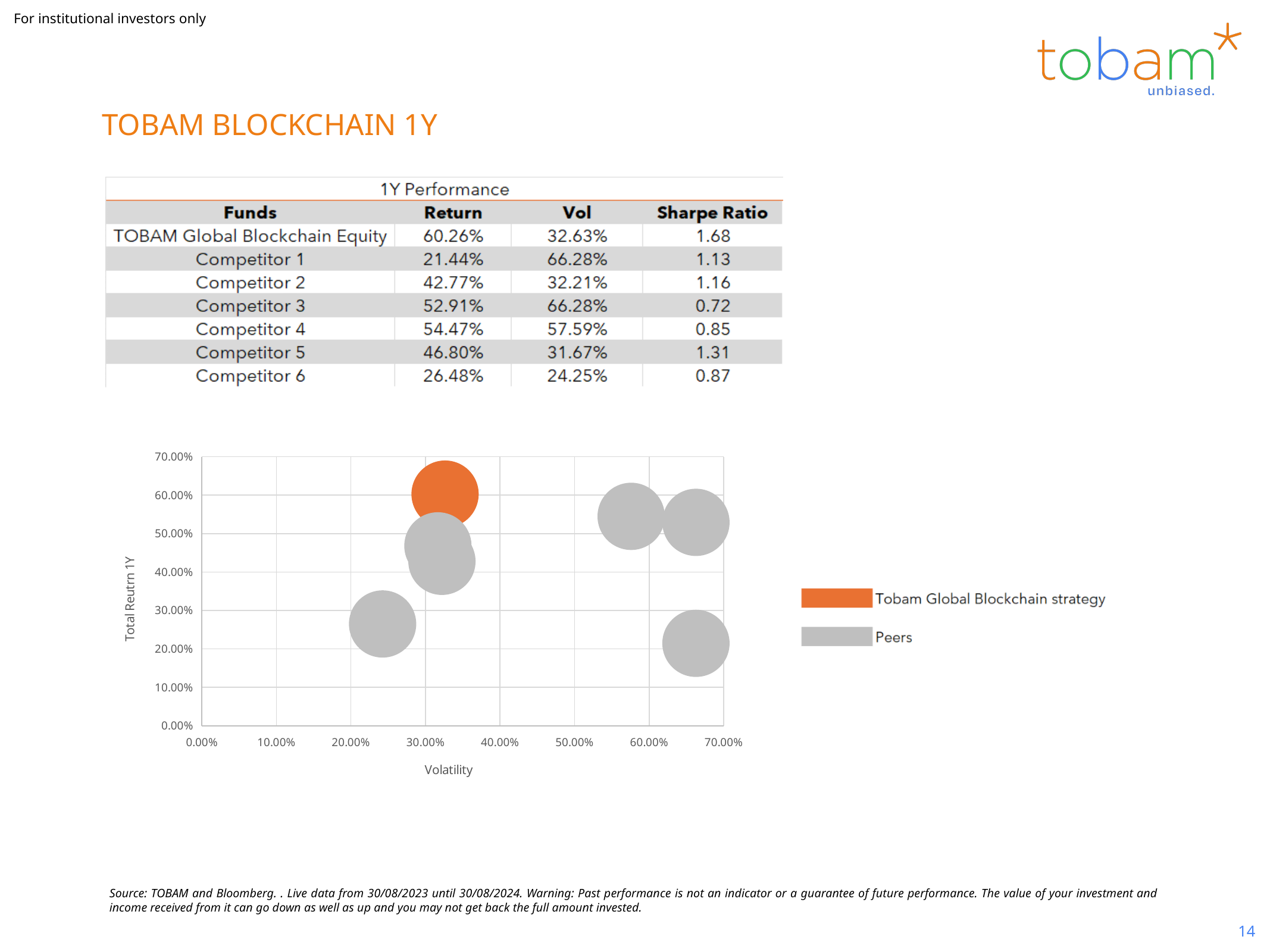
What is the title of the chart's horizontal axis? Volatility What kind of chart is shown on the slide? Bubble chart What colour is the Tobam Global Blockchain strategy bubble in the chart? Orange How many grey Peers bubbles are plotted on the chart? 6 Which has the higher Total Return 1Y: the orange Tobam Global Blockchain strategy bubble or the highest grey Peers bubble? Tobam Global Blockchain strategy Is the Volatility of the Tobam Global Blockchain strategy bubble greater or less than 40.00%? less Is the Volatility of the leftmost Peers bubble greater or less than 30.00%? less How many series does the chart legend list? 2 How many bubbles are plotted on the chart? 7 Is the Total Return 1Y of the Tobam Global Blockchain strategy bubble greater or less than 50.00%? greater Which series has the bubble with the highest Total Return 1Y? Tobam Global Blockchain strategy